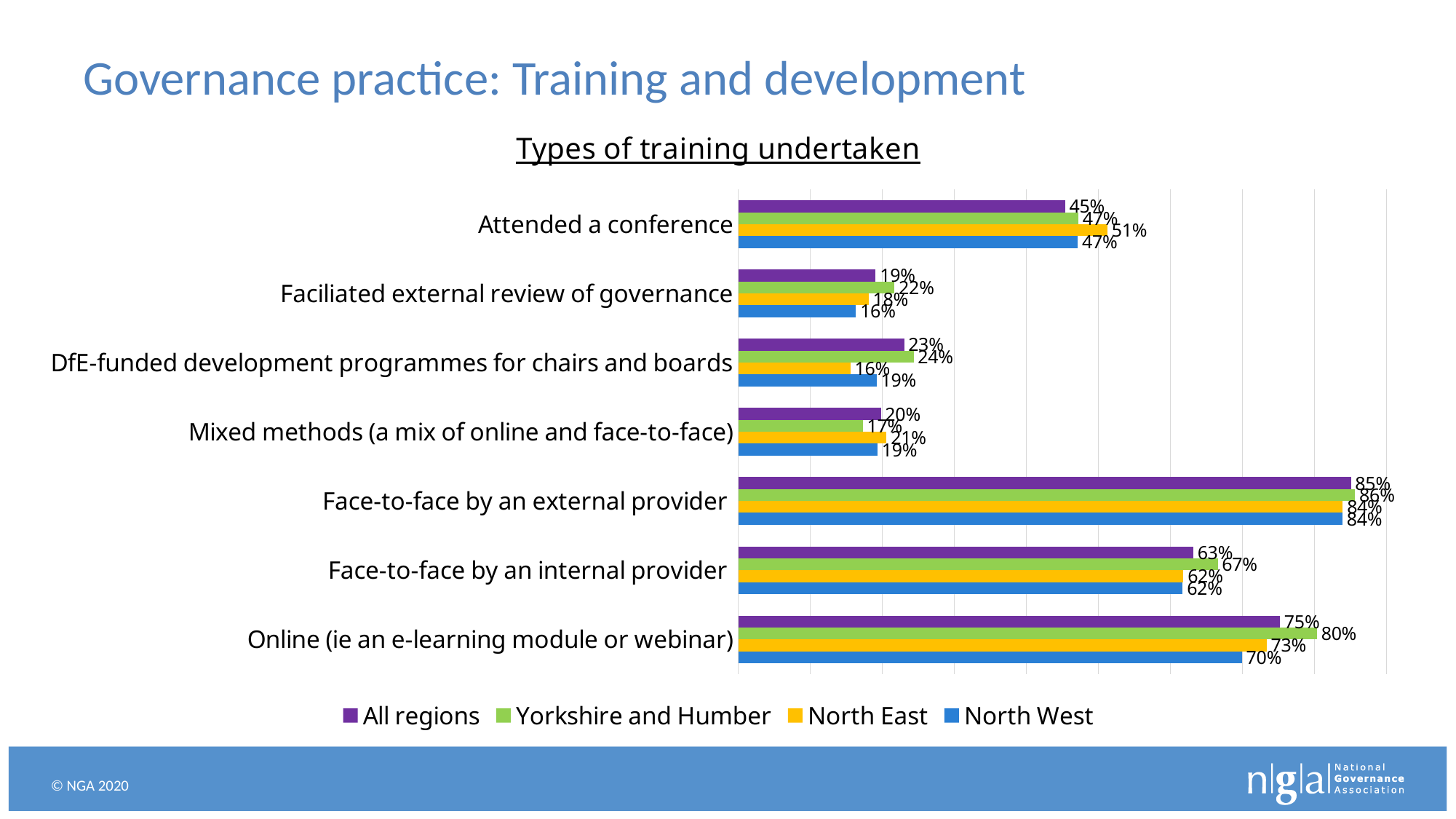
Which region has the lowest value for 'DfE-funded development programmes for chairs and boards'? North East How many types of training are shown on the chart? 7 What kind of chart is shown on the slide? Bar chart What is the value for North West for 'Faciliated external review of governance'? 16% Which colour represents North East in the chart? Yellow What is the value for All regions for 'Face-to-face by an internal provider'? 63% Which is larger for 'Mixed methods (a mix of online and face-to-face)': North East or Yorkshire and Humber? North East What is the value for North East for 'Attended a conference'? 51% What is the difference between Yorkshire and Humber and North West for 'Online (ie an e-learning module or webinar)'? 10% How many series does the legend list? 4 Which type of training has the highest value for All regions? Face-to-face by an external provider What is the value for Yorkshire and Humber for 'Online (ie an e-learning module or webinar)'? 80%